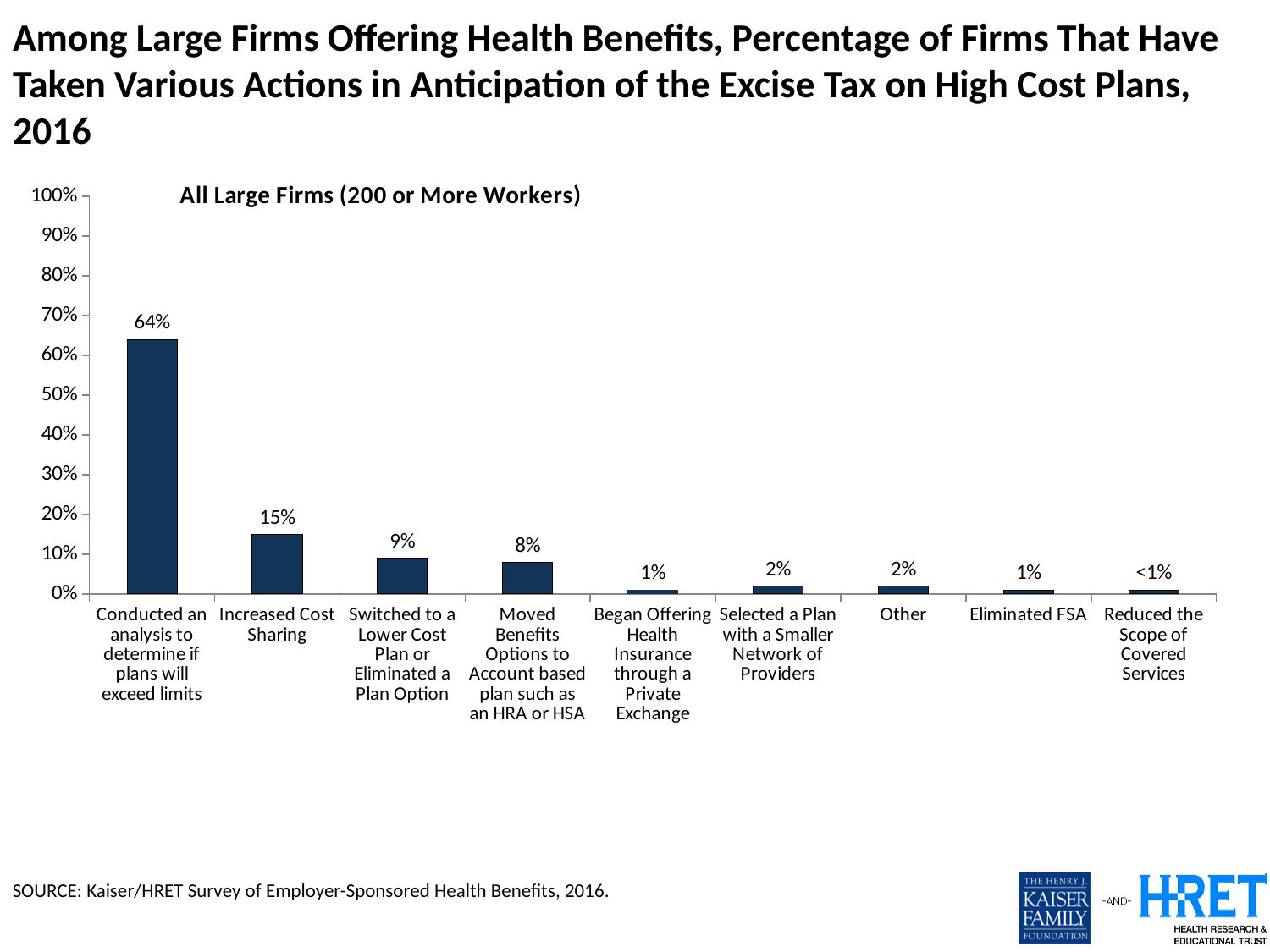
What is the subtitle shown above the chart area? All Large Firms (200 or More Workers) What percentage of large firms conducted an analysis to determine if plans will exceed limits? 64% Which action has the highest percentage of firms? Conducted an analysis to determine if plans will exceed limits Which action has the lowest percentage of firms? Reduced the Scope of Covered Services What type of chart is shown on the slide? Bar chart What value is shown for 'Reduced the Scope of Covered Services'? <1% What percentage of large firms increased cost sharing? 15% What percentage of large firms switched to a lower cost plan or eliminated a plan option? 9% Which is larger: the percentage for 'Switched to a Lower Cost Plan or Eliminated a Plan Option' or for 'Moved Benefits Options to Account based plan such as an HRA or HSA'? Switched to a Lower Cost Plan or Eliminated a Plan Option How many action categories are shown on the chart? 9 What percentage of large firms moved benefits options to account based plans such as an HRA or HSA? 8% What is the difference in percentage points between 'Conducted an analysis to determine if plans will exceed limits' and 'Increased Cost Sharing'? 49 percentage points